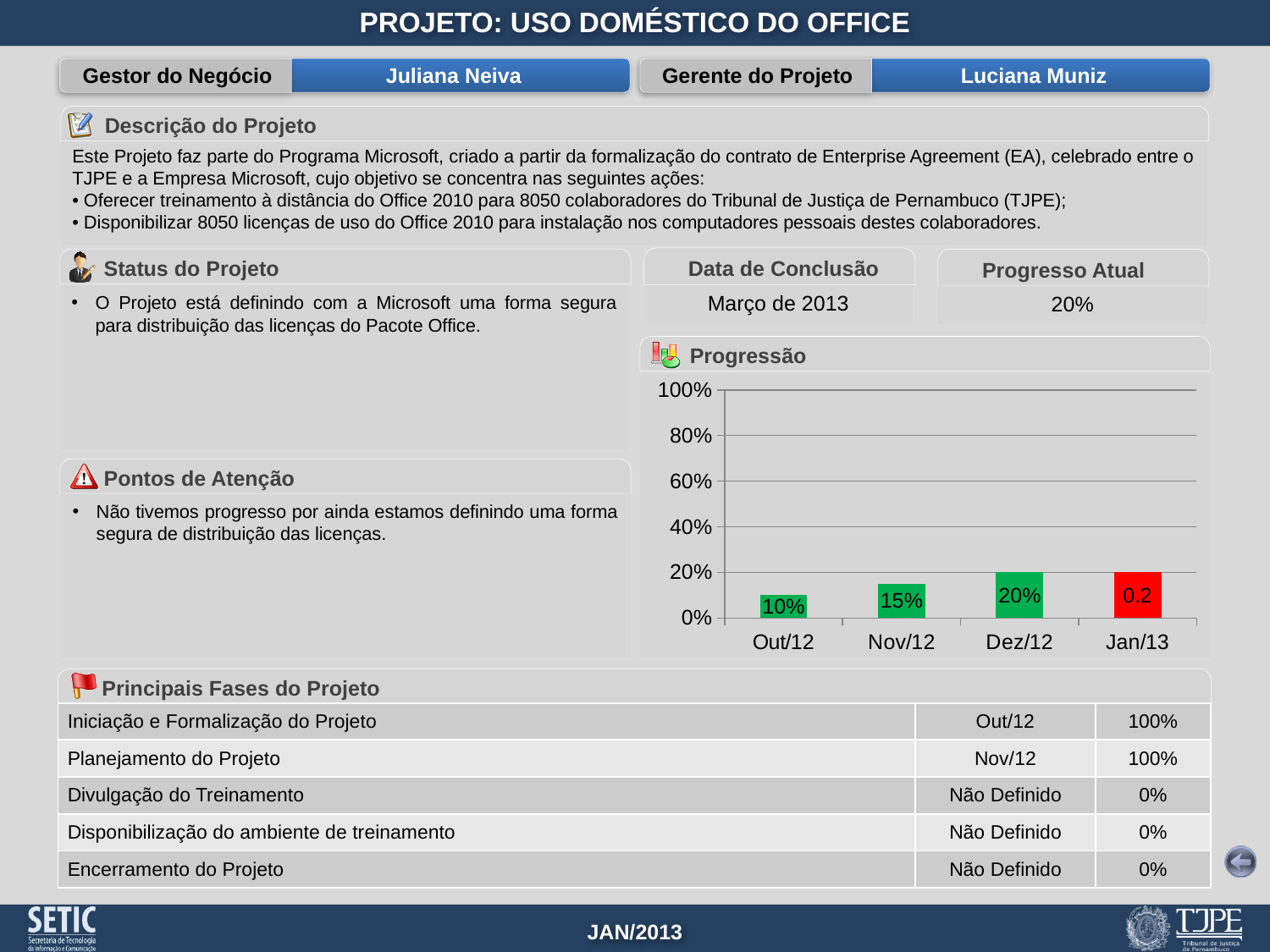
What is the difference between the Dez/12 and Out/12 values in the Progressão chart? 10% What is the difference between the Nov/12 and Out/12 values in the Progressão chart? 5% What data label is printed on the Jan/13 bar in the Progressão chart? 0.2 Is the value for Out/12 in the Progressão chart greater or less than 20%? less In the Progressão chart, which is larger: the value for Dez/12 or the value for Out/12? Dez/12 Which month has the lowest value in the Progressão chart? Out/12 What value is shown for Out/12 in the Progressão chart? 10% How many months are plotted in the Progressão chart? 4 What kind of chart is the Progressão chart? bar chart What value is shown for Nov/12 in the Progressão chart? 15% What colour is the Jan/13 bar in the Progressão chart? red What value is shown for Dez/12 in the Progressão chart? 20%